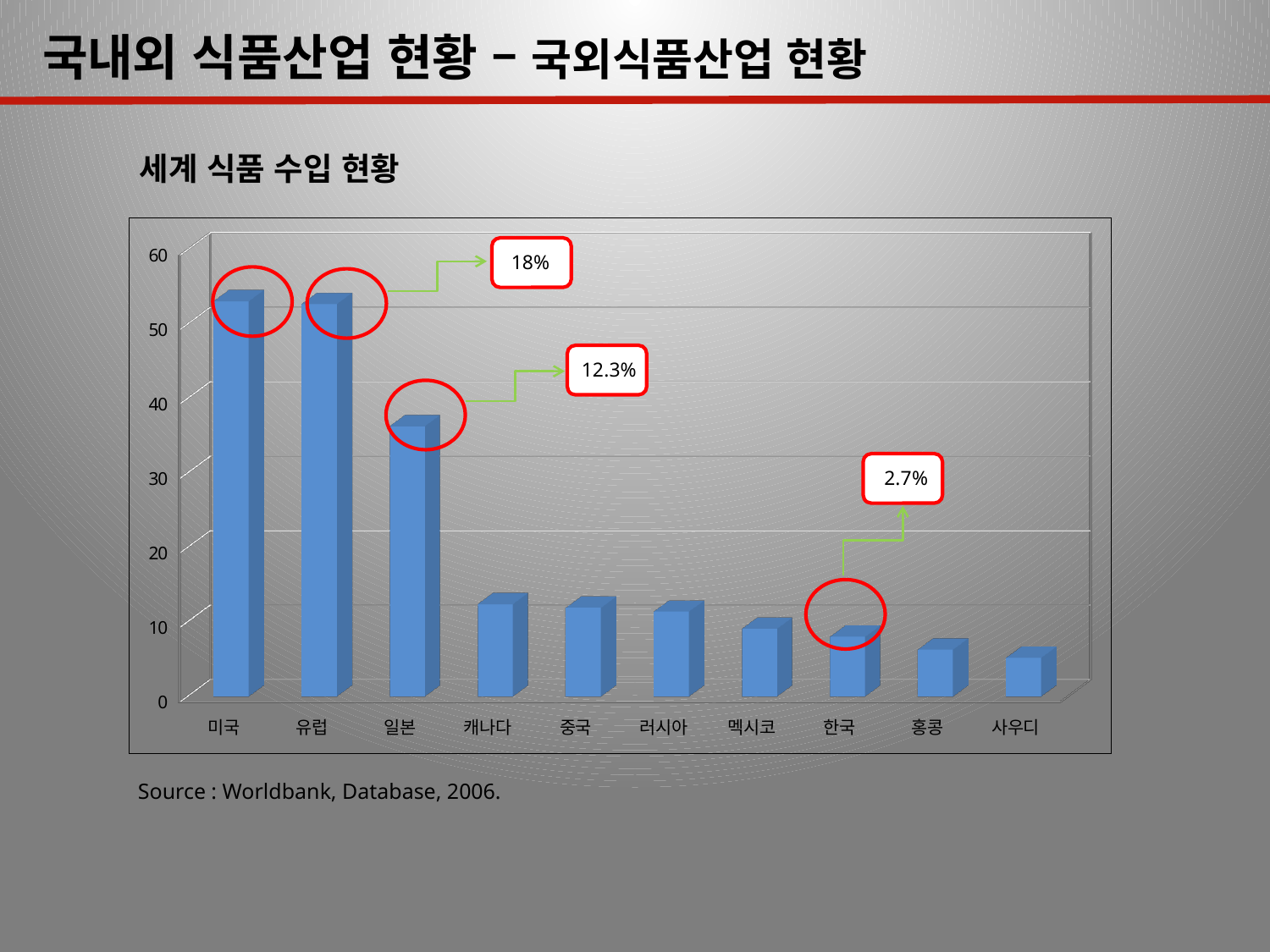
Is the value for 사우디 greater or less than 10? less What percentage is shown in the callout pointing to the 일본 bar? 12.3% What is the title shown above the chart? 세계 식품 수입 현황 Is the value for 미국 greater or less than 50? greater Is the value for 캐나다 greater or less than 10? greater Which has the larger value, 일본 or 캐나다? 일본 What kind of chart is shown on the slide? bar chart Which category has the lowest bar in the chart? 사우디 How many countries/regions are shown on the x axis of the chart? 10 Which has the larger value, 한국 or 미국? 미국 Do the bar values generally rise or fall from left to right along the x axis? fall